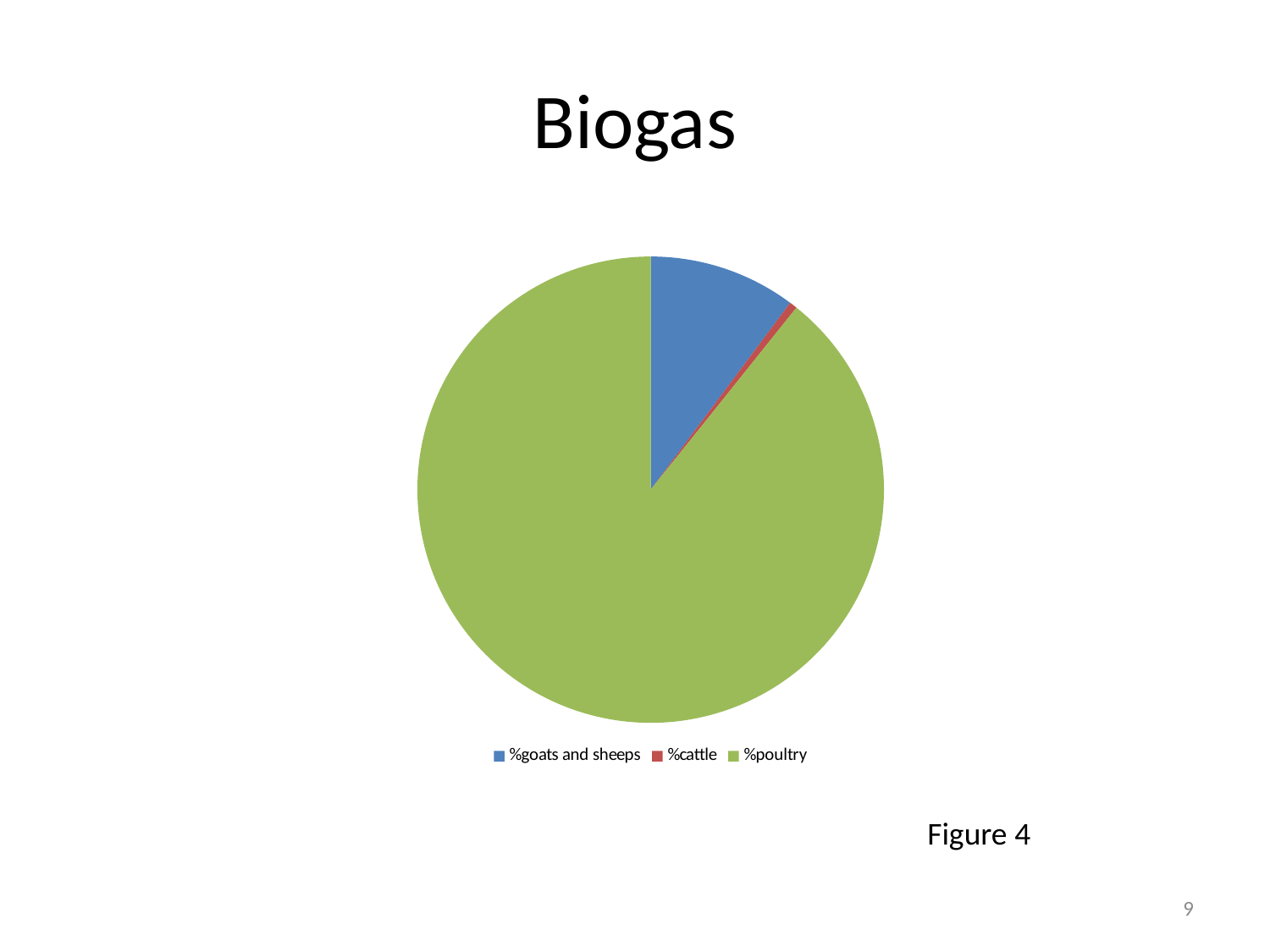
Which slice is larger, %poultry or %goats and sheeps? %poultry What colour is the %poultry slice in the pie chart? green Which category has the smallest slice of the pie chart? %cattle Which category has the largest slice of the pie chart? %poultry What is the title of the slide containing the pie chart? Biogas What kind of chart is shown on the slide? pie chart How many slices does the pie chart have? 3 How many entries does the legend of the pie chart list? 3 Which slice is larger, %goats and sheeps or %cattle? %goats and sheeps Does the %poultry slice take up more or less than half of the pie? more